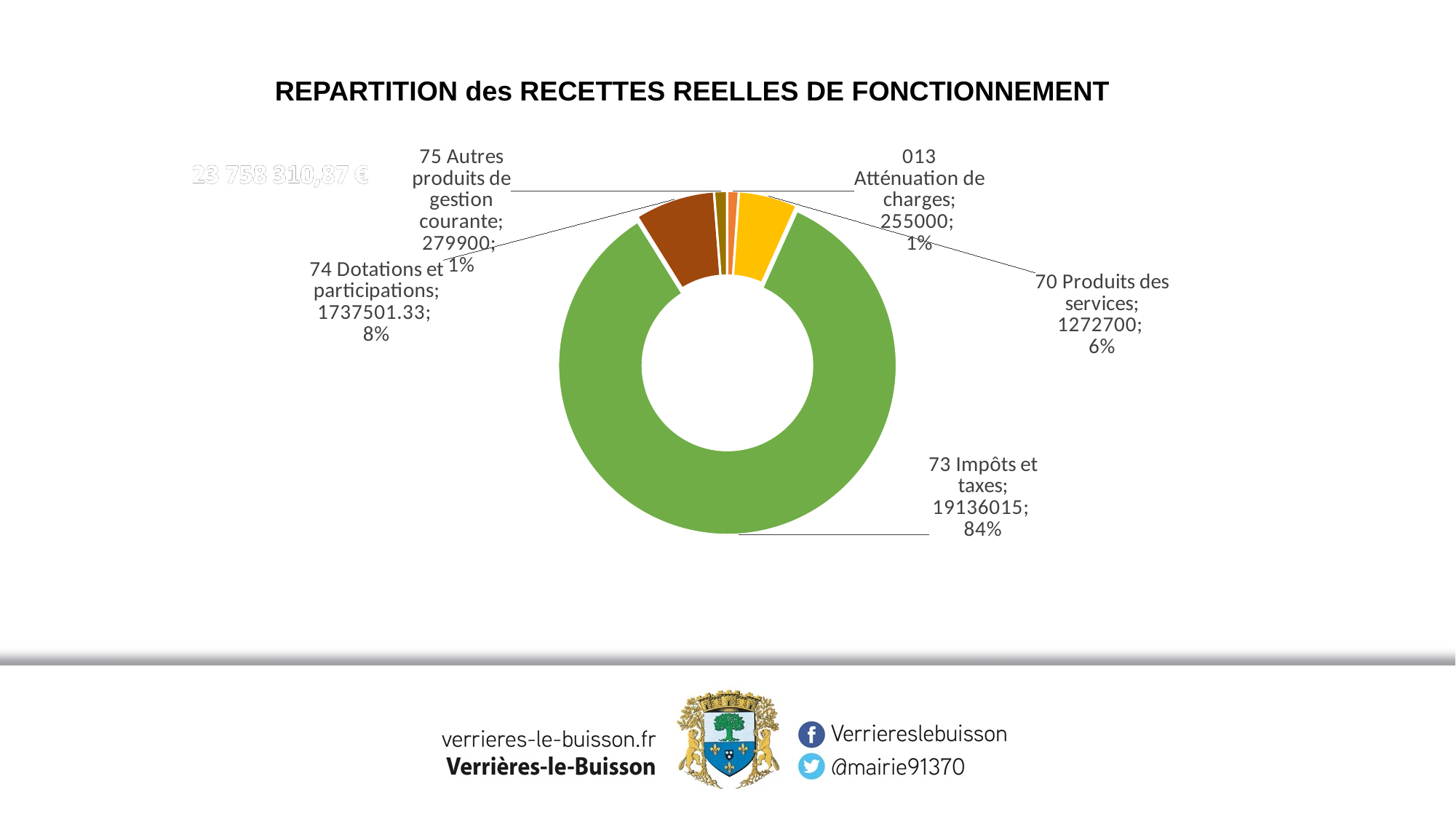
What is the value for 013 Atténuation de charges? 255000 How many categories are shown in the chart? 5 What is the title of the chart? REPARTITION des RECETTES REELLES DE FONCTIONNEMENT Which is larger, the value for 75 Autres produits de gestion courante or 013 Atténuation de charges? 75 Autres produits de gestion courante What is the value for 73 Impôts et taxes? 19136015 Which category has the largest share of the chart? 73 Impôts et taxes What percentage share does 70 Produits des services represent? 6% Which category has the smallest value? 013 Atténuation de charges What percentage share does 74 Dotations et participations represent? 8% What is the value for 70 Produits des services? 1272700 What is the difference between the values for 74 Dotations et participations and 70 Produits des services? 464801.33 What kind of chart is shown on the slide? Doughnut (pie) chart